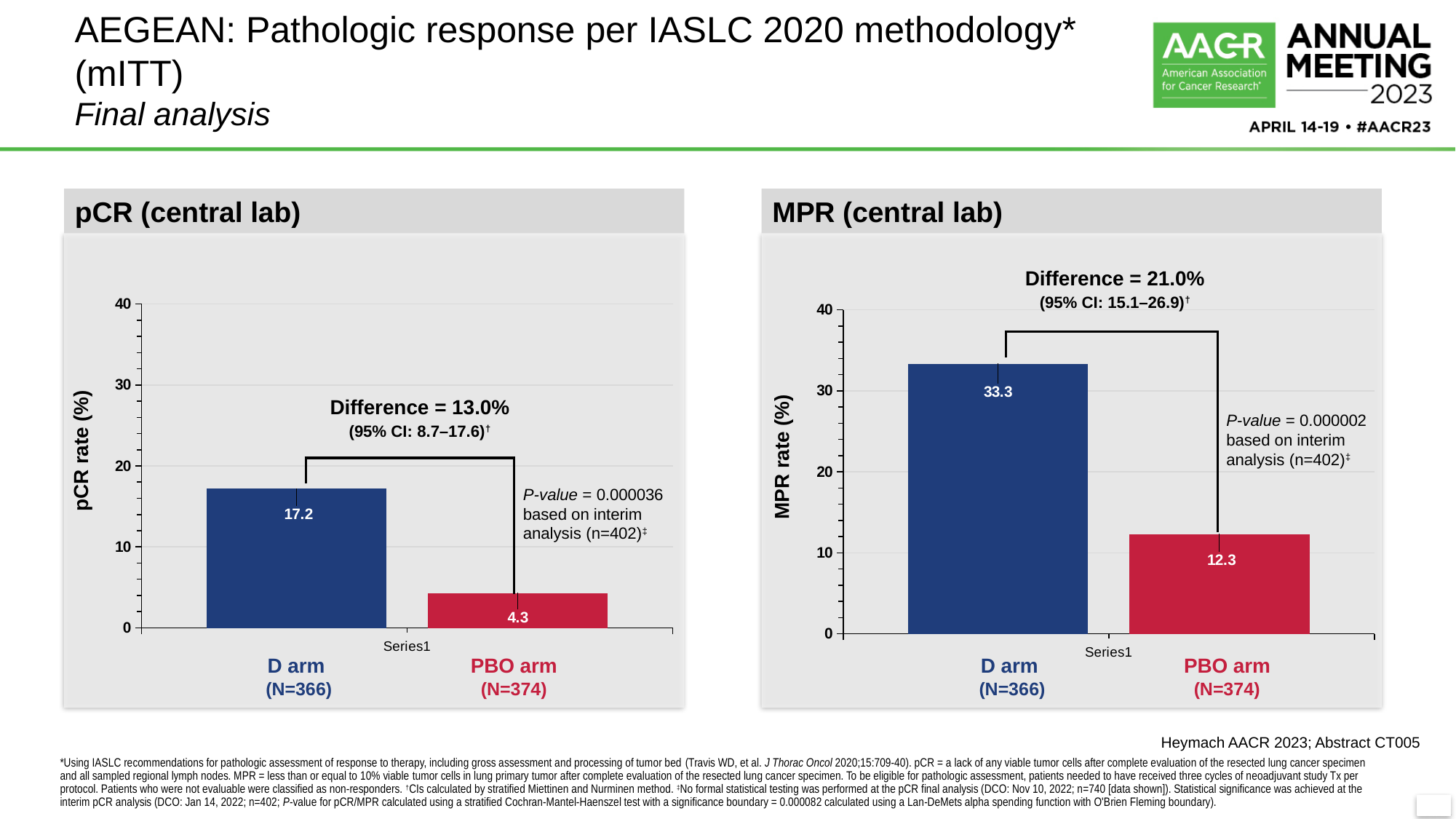
In the pCR (central lab) chart, what is the pCR rate for the D arm? 17.2 In the pCR (central lab) chart, what is the pCR rate for the PBO arm? 4.3 In the MPR (central lab) chart, what is the MPR rate for the PBO arm? 12.3 What kind of chart is the pCR (central lab) chart? Bar chart In the MPR (central lab) chart, what is the MPR rate for the D arm? 33.3 In the MPR (central lab) chart, what is the difference between the D arm and PBO arm MPR rates? 21.0 In the pCR (central lab) chart, is the value for the PBO arm greater or less than 10? less In the pCR (central lab) chart, which arm has the higher pCR rate? D arm In the MPR (central lab) chart, which arm has the lower MPR rate? PBO arm In the MPR (central lab) chart, is the value for the D arm greater or less than 30? greater How many bars are shown in the MPR (central lab) chart? 2 In the pCR (central lab) chart, what is the difference between the D arm and PBO arm pCR rates? 13.0%